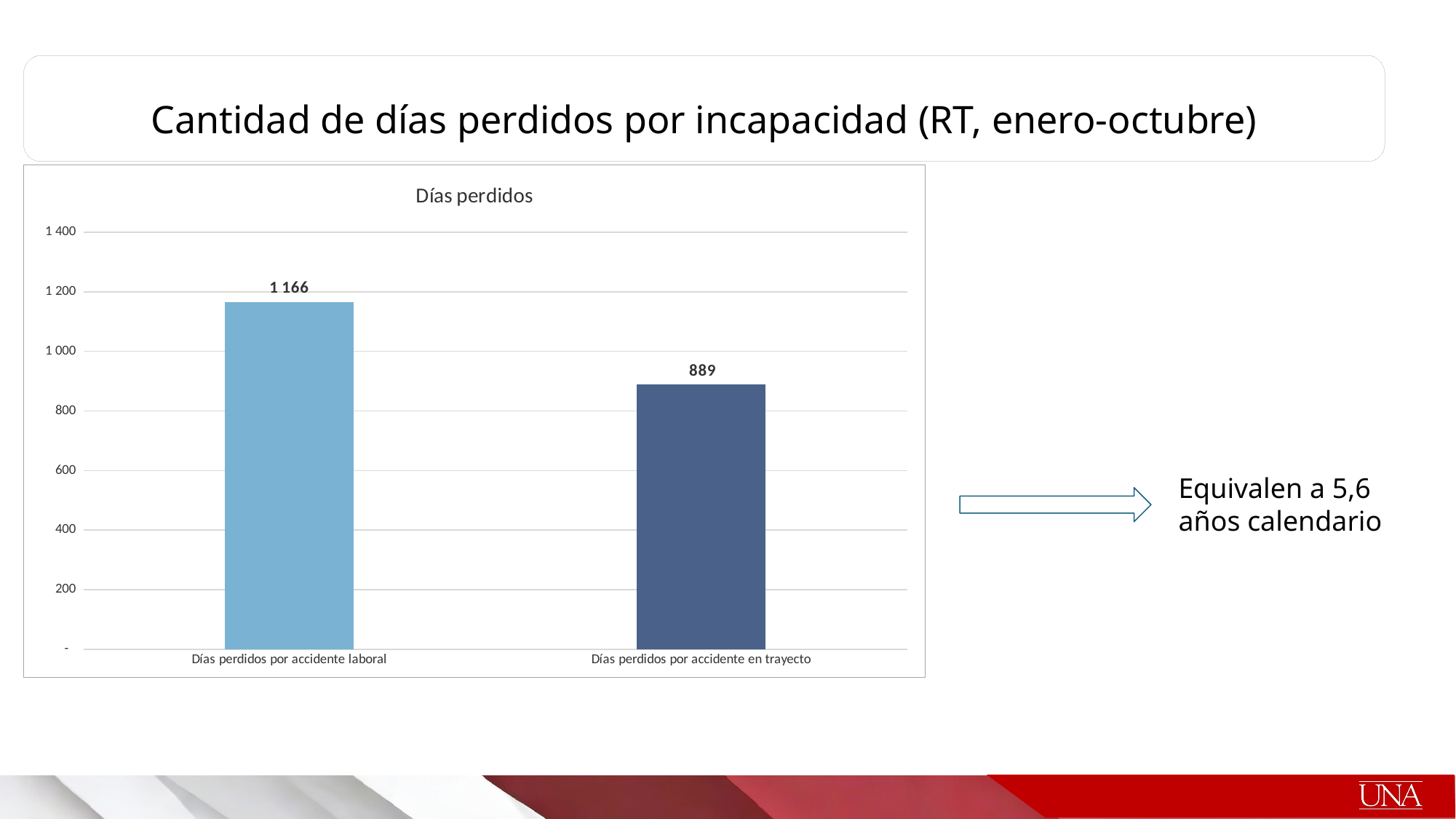
What is the difference between the values for 'Días perdidos por accidente laboral' and 'Días perdidos por accidente en trayecto'? 277 Is the value for 'Días perdidos por accidente en trayecto' greater or less than 1 000? less Is the value for 'Días perdidos por accidente laboral' greater or less than 1 000? greater How many categories are shown in the chart? 2 What is the title of the chart? Días perdidos Which is larger: the value for 'Días perdidos por accidente laboral' or 'Días perdidos por accidente en trayecto'? Días perdidos por accidente laboral Which category has the highest value? Días perdidos por accidente laboral Which category has the lowest value? Días perdidos por accidente en trayecto What is the highest value shown on the vertical axis? 1 400 What kind of chart is shown on the slide? bar chart What is the value for 'Días perdidos por accidente en trayecto'? 889 What is the value for 'Días perdidos por accidente laboral'? 1 166